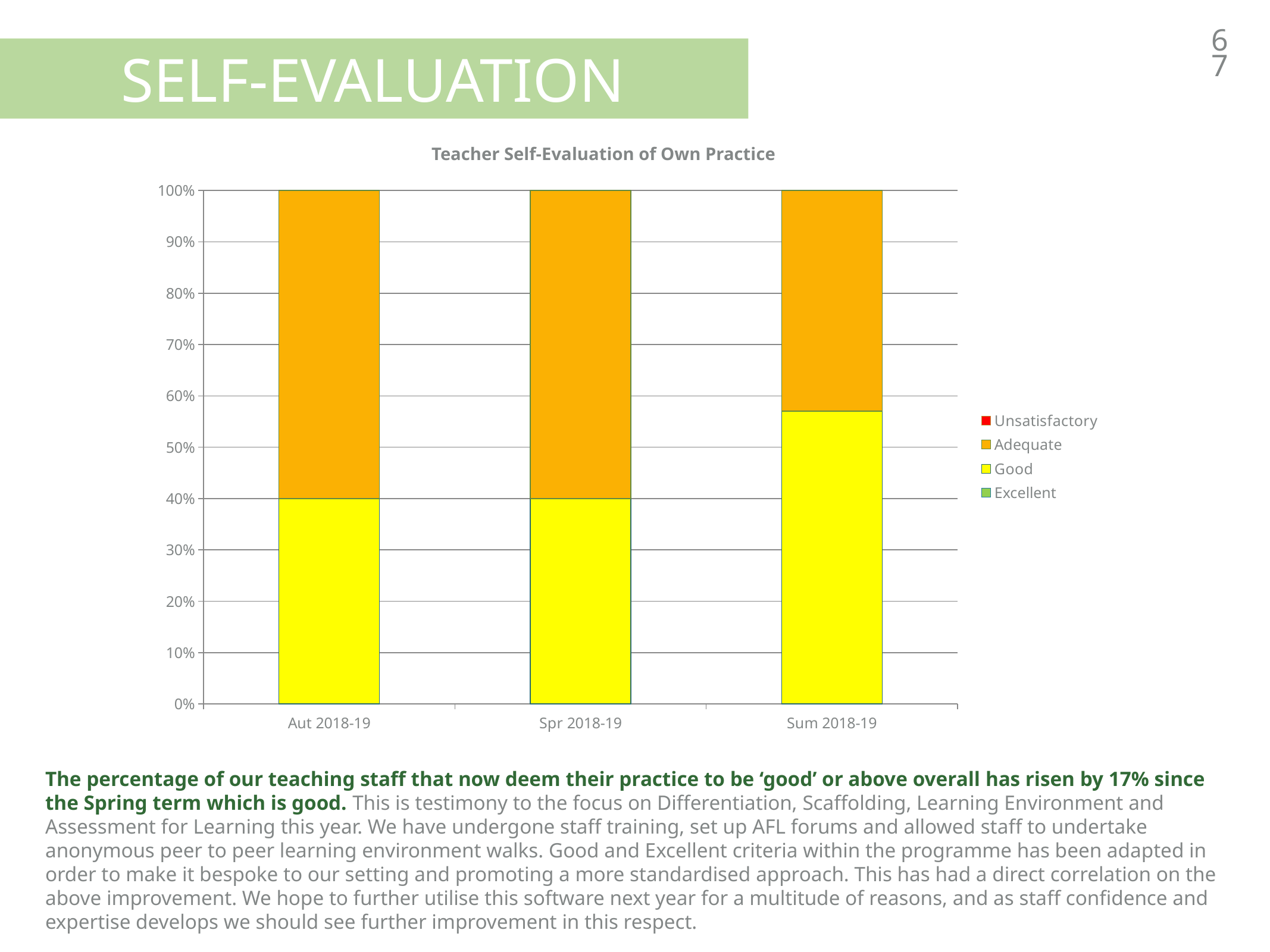
Is the Adequate share for Sum 2018-19 greater or less than 50%? less Which colour represents the Good series in the legend? Yellow Is the Good share for Sum 2018-19 greater or less than 50%? greater How many terms (categories) are shown on the x axis? 3 Which term has the highest share of Good ratings? Sum 2018-19 What percentage of staff rated their practice as Good in Aut 2018-19? 40% Which term has the lowest share of Adequate ratings? Sum 2018-19 What kind of chart is shown on the slide? Stacked bar chart What percentage of staff rated their practice as Good in Spr 2018-19? 40% What is the title of the chart? Teacher Self-Evaluation of Own Practice Is the Good share larger in Sum 2018-19 or in Aut 2018-19? Sum 2018-19 How many series does the legend list? 4